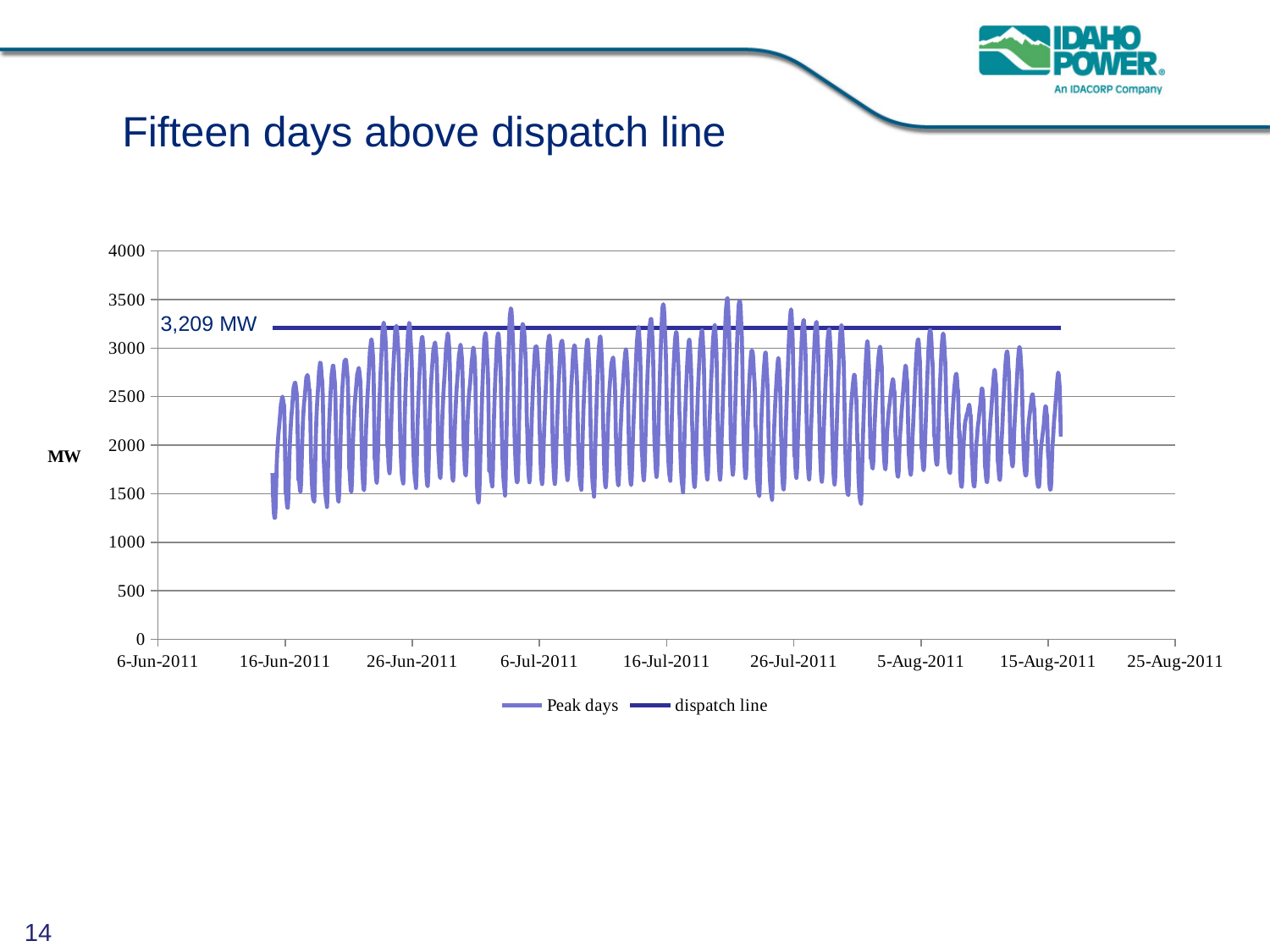
Is the lowest value of the Peak days series greater or less than 1500 MW? less Is the dispatch line greater or less than 3000 MW? greater How many date labels are shown on the x axis? 9 What is the highest tick value shown on the y axis? 4000 What are the two series named in the legend? Peak days and dispatch line What unit is shown on the vertical axis label? MW What value is labelled on the dispatch line? 3,209 MW Is the dispatch line greater or less than 3500 MW? less How many series does the legend list? 2 What kind of chart is shown on the slide? line chart Does the dispatch line rise, fall, or stay flat across the x axis? stays flat